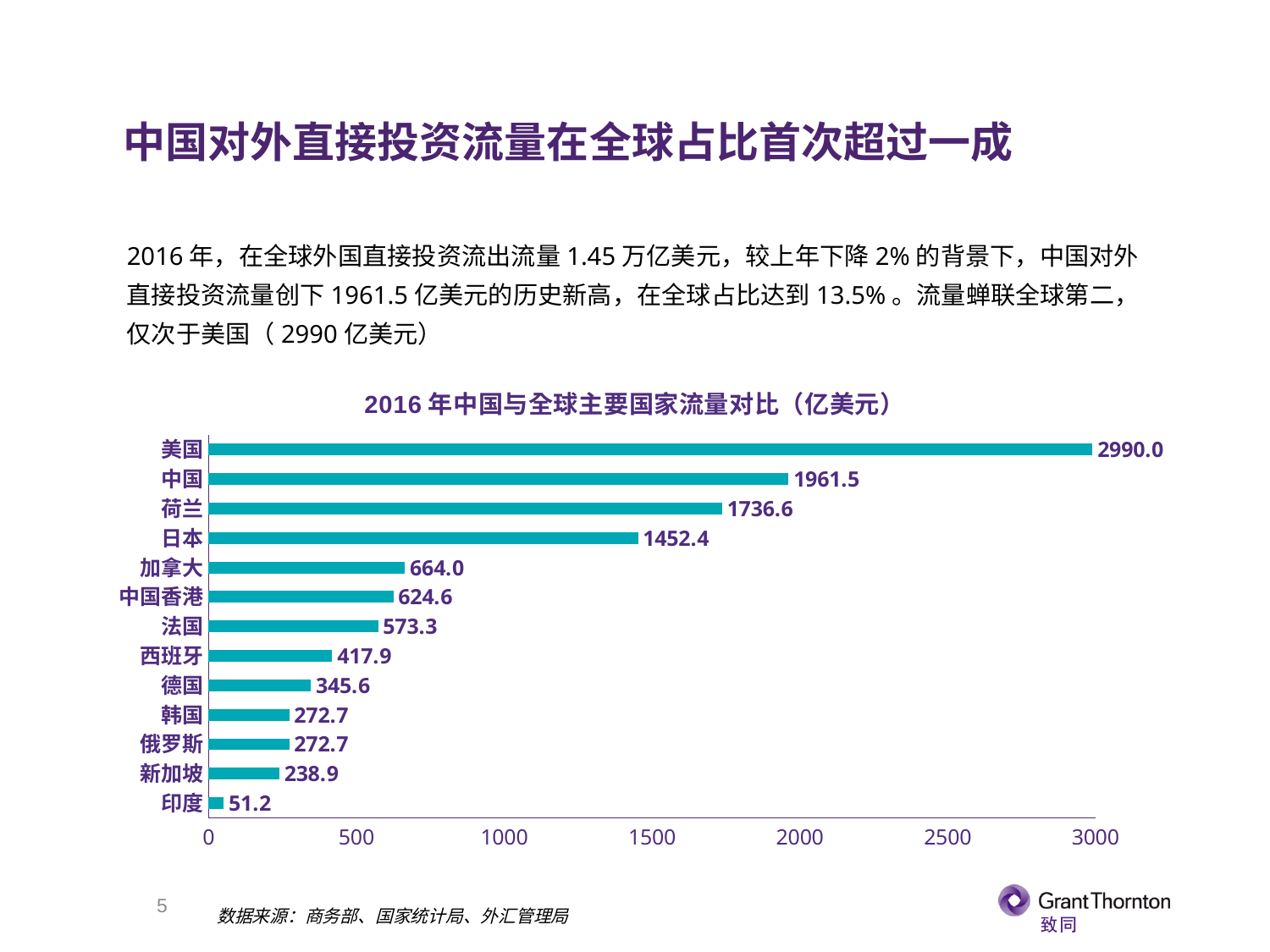
Which is larger, the value for 日本 or the value for 荷兰? 荷兰 What is the value for 印度 in the chart? 51.2 Which country has the highest value in the chart? 美国 How many countries or regions are shown in the chart? 13 What kind of chart is shown on the slide? bar chart What is the difference between the values for 美国 and 中国? 1028.5 Is the value for 法国 greater or less than 500? greater What is the value for 荷兰 in the chart? 1736.6 What is the title of the chart? 2016 年中国与全球主要国家流量对比（亿美元） What is the difference between the values for 加拿大 and 中国香港? 39.4 Which country has the lowest value in the chart? 印度 What is the value for 中国 in the chart? 1961.5